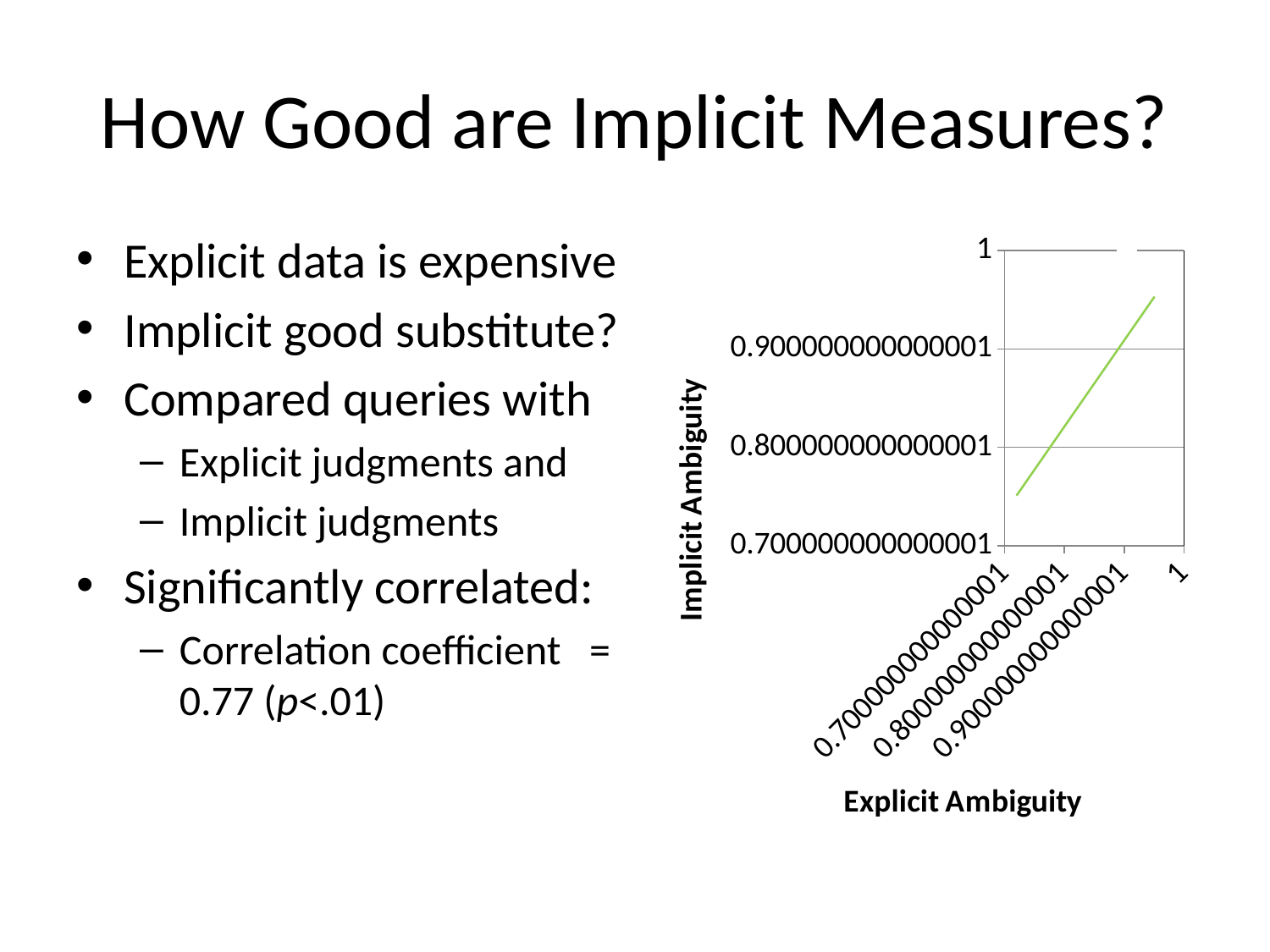
What kind of chart is shown on the slide? line chart Is the Implicit Ambiguity value at the right end of the line greater or less than 1? less Is the Implicit Ambiguity value at the right end of the line greater or less than 0.9? greater Does the line in the chart rise or fall as Explicit Ambiguity increases along the x axis? rise What is the title of the x axis of the chart? Explicit Ambiguity What is the title of the y axis of the chart? Implicit Ambiguity Is the Implicit Ambiguity value at the left end of the line greater or less than 0.7? greater How many lines are plotted in the chart? 1